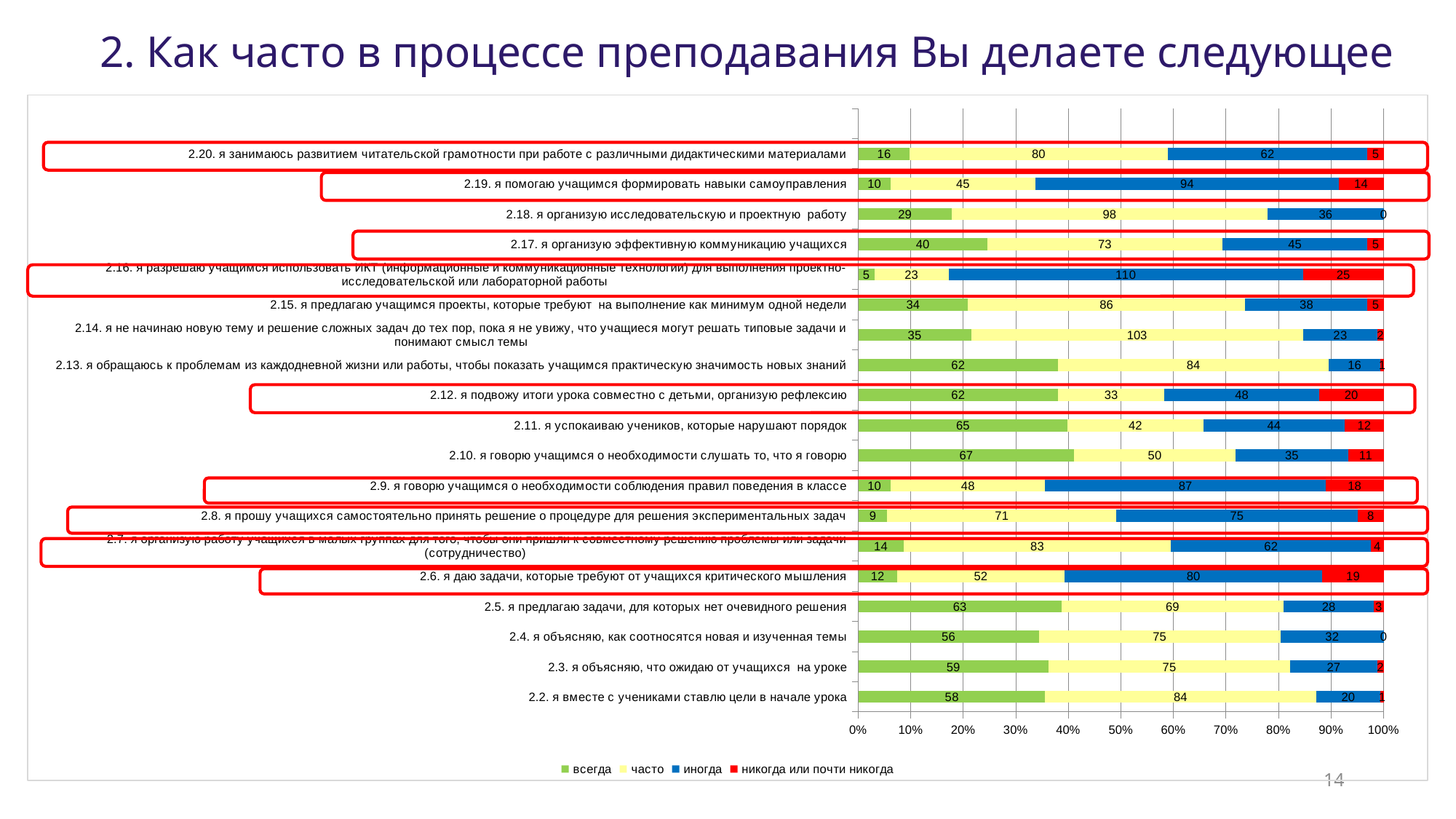
What is the value of 'иногда' for statement 2.16 (я разрешаю учащимся использовать ИКТ...)? 110 What is the value of 'всегда' for statement 2.10 (я говорю учащимся о необходимости слушать то, что я говорю)? 67 Which statement has the lowest value for 'всегда'? 2.16. я разрешаю учащимся использовать ИКТ (информационные и коммуникационные технологии) для выполнения проектно-исследовательской или лабораторной работы What is the total of all four segments for statement 2.2 (я вместе с учениками ставлю цели в начале урока)? 163 What kind of chart is shown on the slide? stacked bar chart Which colour represents the series 'никогда или почти никогда' in the legend? red How many series does the legend list? 4 Which is larger: the 'всегда' value for statement 2.17 or the 'всегда' value for statement 2.18? 2.17 (40) What is the value of 'никогда или почти никогда' for statement 2.12 (я подвожу итоги урока совместно с детьми, организую рефлексию)? 20 Which statement has the highest value for 'иногда'? 2.16. я разрешаю учащимся использовать ИКТ (информационные и коммуникационные технологии) для выполнения проектно-исследовательской или лабораторной работы What is the difference between the 'часто' values for statement 2.14 and statement 2.12? 70 How many categories (statements) are plotted in the chart? 19